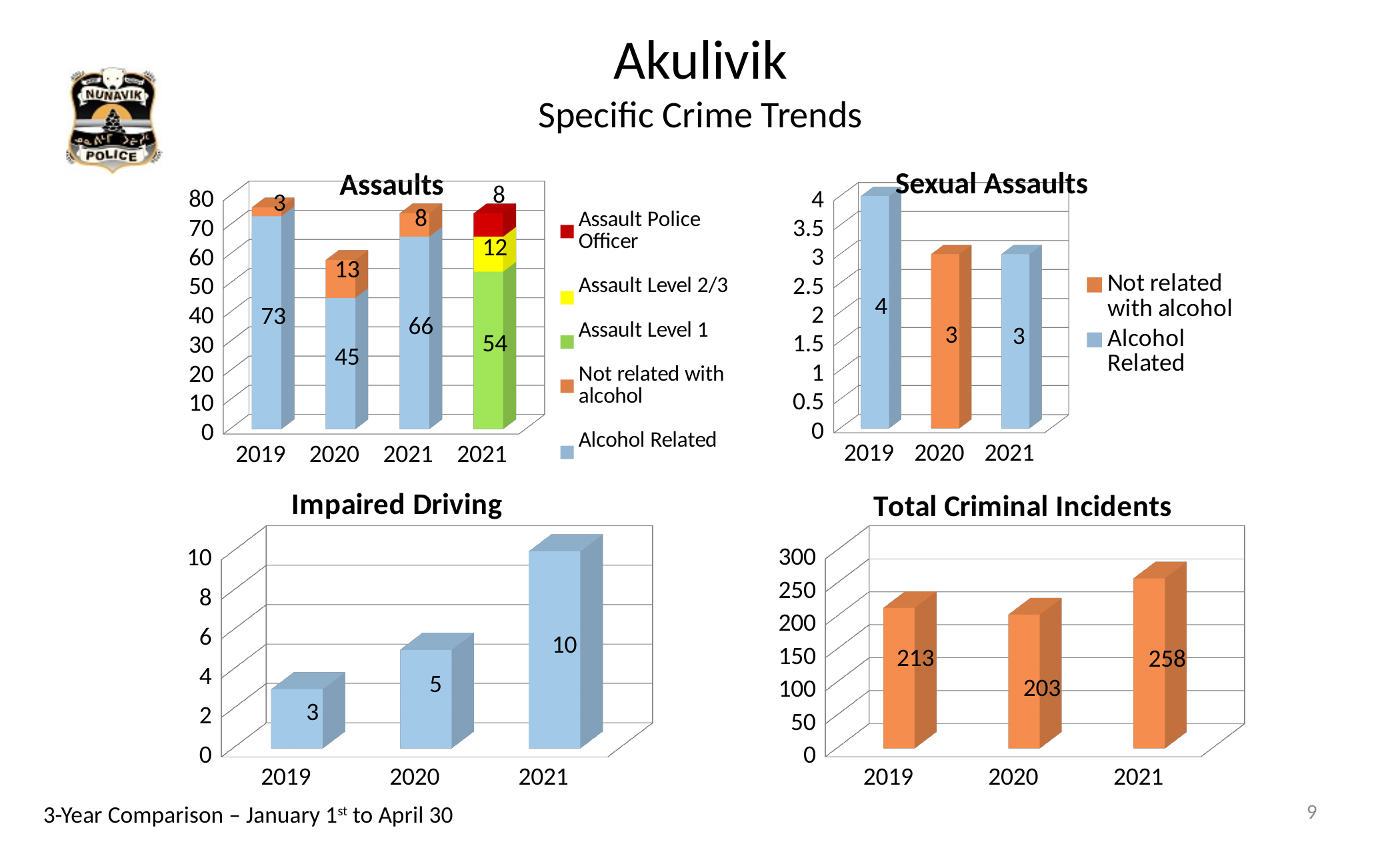
In the Total Criminal Incidents chart, which year has the lowest value? 2020 In the Assaults chart, how many series does the legend list? 5 In the Total Criminal Incidents chart, what is the difference between the 2021 and 2019 values? 45 In the Impaired Driving chart, how many years are shown on the x axis? 3 What kind of chart is the Sexual Assaults chart? bar chart In the Assaults chart, what is the Alcohol Related value for 2020? 45 In the Impaired Driving chart, what is the value for 2020? 5 In the Assaults chart, what is the Assault Level 2/3 value for 2021? 12 In the Total Criminal Incidents chart, what is the value for 2021? 258 In the Assaults chart, what is the total of the stacked bar for 2019? 76 In the Impaired Driving chart, do the values rise or fall from 2019 to 2021? rise In the Sexual Assaults chart, what is the value for 2019? 4